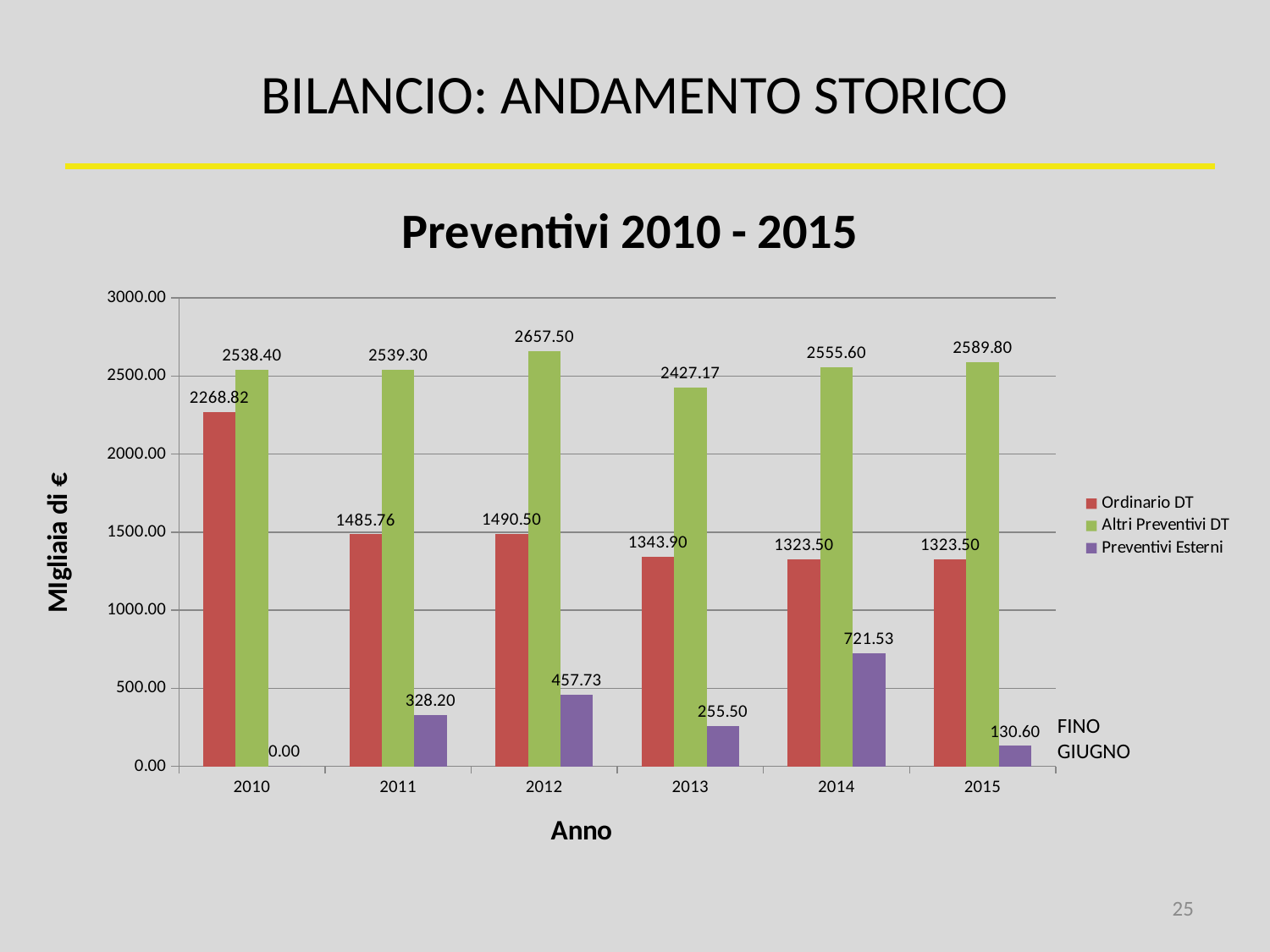
What is the value of Preventivi Esterni for 2010? 0.00 How many years are shown on the x axis? 6 What is the value of Altri Preventivi DT for 2012? 2657.50 How many series does the legend list? 3 What kind of chart is shown? Bar chart What is the value of Preventivi Esterni for 2014? 721.53 In which year is Preventivi Esterni highest? 2014 In which year is Altri Preventivi DT highest? 2012 Which is larger in 2013, Ordinario DT or Altri Preventivi DT? Altri Preventivi DT What is the difference between Altri Preventivi DT and Ordinario DT in 2015? 1266.30 What is the value of Ordinario DT for 2010? 2268.82 In which year is Altri Preventivi DT lowest? 2013